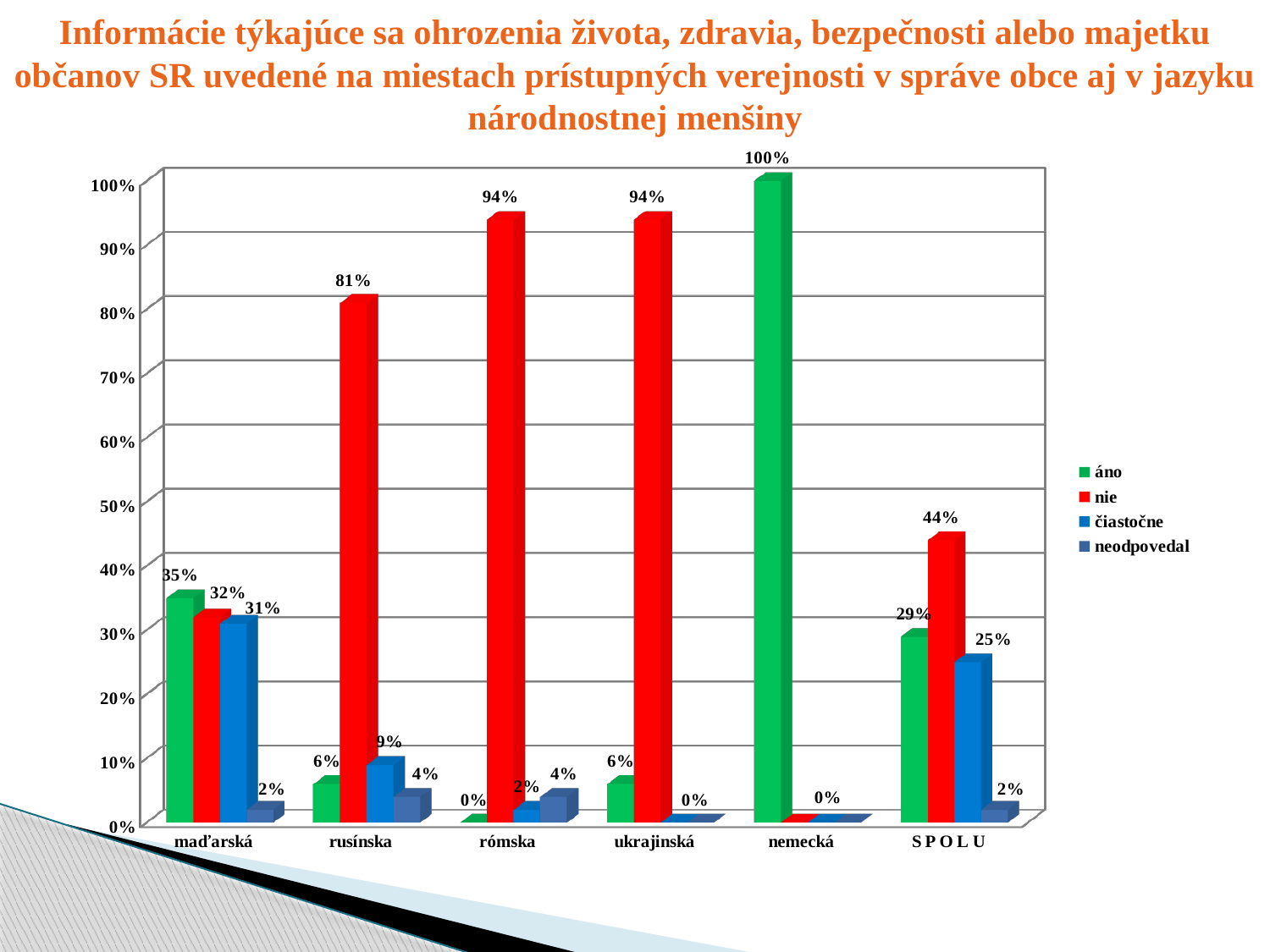
What is the value of 'neodpovedal' for rómska? 4% What is the value of 'áno' for nemecká? 100% How many series does the legend list? 4 What is the difference between 'nie' and 'áno' for S P O L U? 15% How many categories are shown on the x axis? 6 Which category has the lowest value for 'nie'? nemecká What is the value of 'nie' for rusínska? 81% Which is larger for maďarská: 'áno' or 'čiastočne'? áno What kind of chart is shown on the slide? bar chart What is the value of 'čiastočne' for S P O L U? 25% Which category has the highest value for 'áno'? nemecká Which legend entry is shown in red? nie